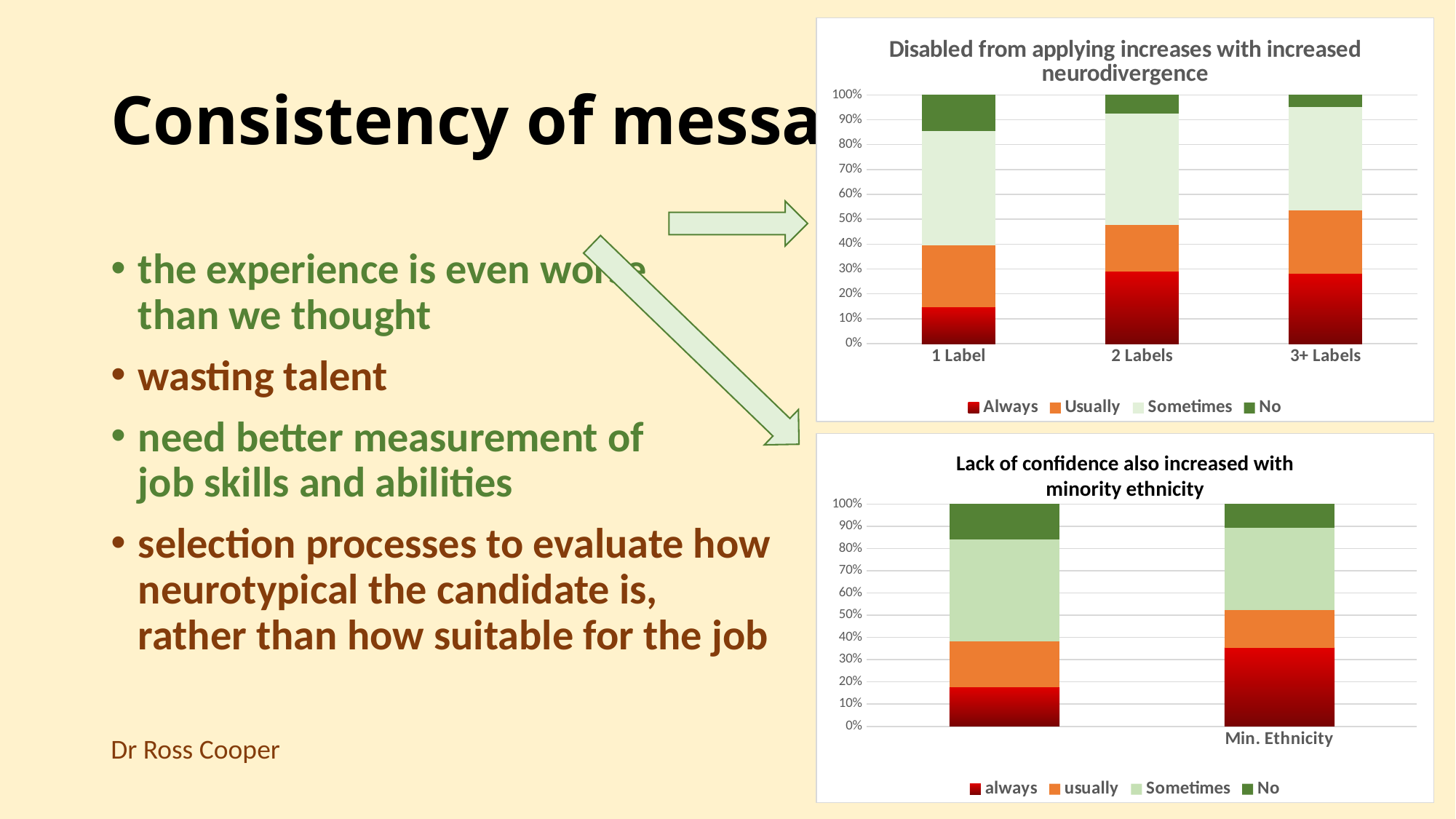
In the chart titled "Disabled from applying increases with increased neurodivergence", which has the larger Always segment, 1 Label or 2 Labels? 2 Labels In the chart titled "Disabled from applying increases with increased neurodivergence", how many categories are shown on the x axis? 3 In the chart titled "Disabled from applying increases with increased neurodivergence", which category has the largest No segment? 1 Label In the chart titled "Disabled from applying increases with increased neurodivergence", what kind of chart is shown? Stacked bar chart In the chart titled "Disabled from applying increases with increased neurodivergence", how many series does the legend list? 4 In the chart titled "Disabled from applying increases with increased neurodivergence", is the Always value for 1 Label greater or less than 20%? less In the chart titled "Lack of confidence also increased with minority ethnicity", what kind of chart is shown? Stacked bar chart In the chart titled "Disabled from applying increases with increased neurodivergence", is the Always value for 2 Labels greater or less than 20%? greater In the chart titled "Lack of confidence also increased with minority ethnicity", how many series does the legend list? 4 In the chart titled "Disabled from applying increases with increased neurodivergence", which category has the smallest No segment? 3+ Labels What are the legend entries of the chart titled "Lack of confidence also increased with minority ethnicity"? always, usually, Sometimes, No In the chart titled "Lack of confidence also increased with minority ethnicity", is the always value for Min. Ethnicity greater or less than 30%? greater